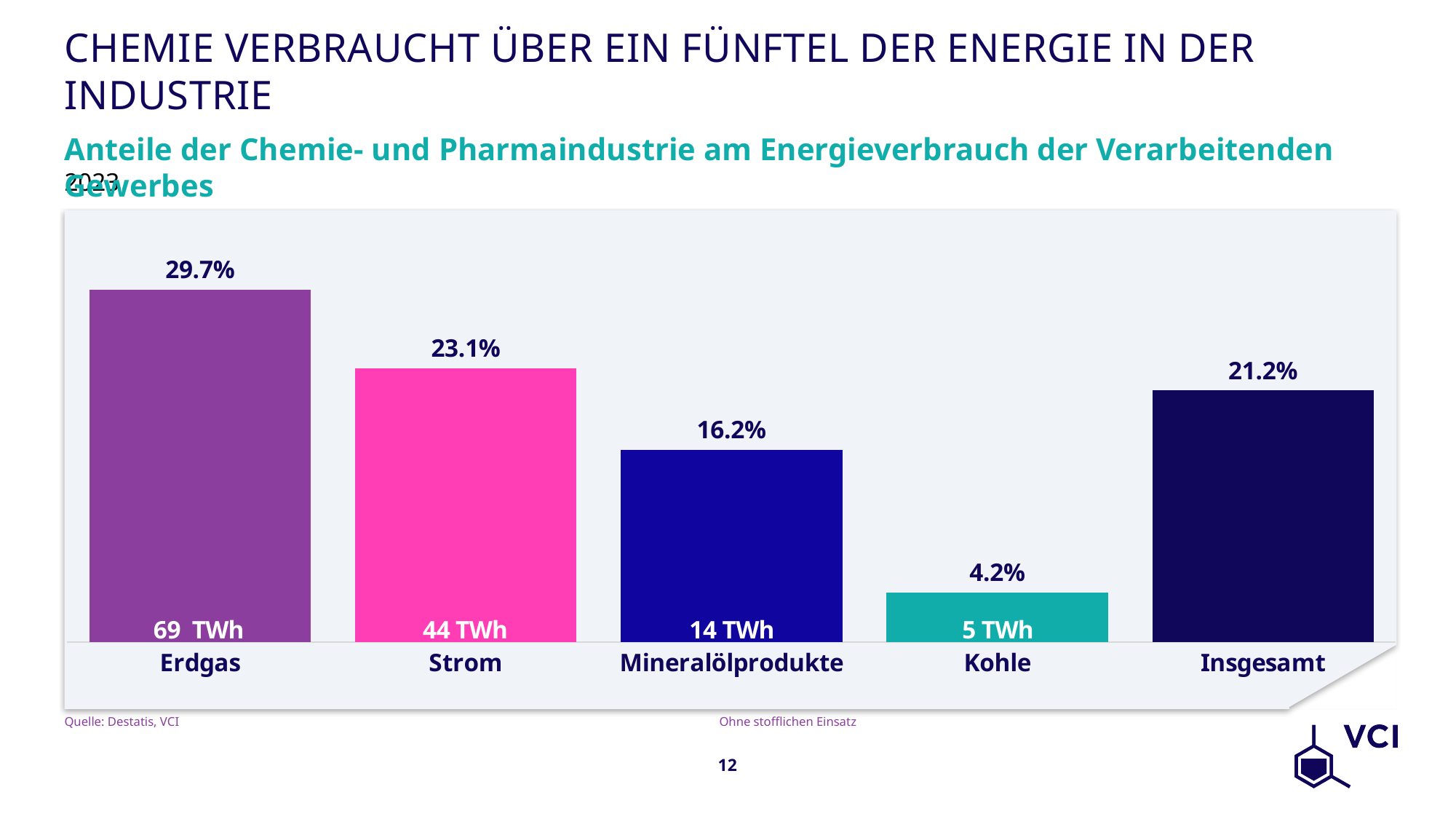
What is the difference in percentage points between Erdgas and Strom? 6.6 What is the percentage share shown for Strom? 23.1% What is the source cited below the chart? Destatis, VCI What is the percentage share shown for Erdgas? 29.7% What type of chart is shown on the slide? Bar chart How many TWh are shown inside the Mineralölprodukte bar? 14 TWh Which category has the highest percentage share? Erdgas Which category has the lowest percentage share? Kohle What is the percentage share shown for Insgesamt? 21.2% How many bars are shown in the chart? 5 What is the percentage share shown for Kohle? 4.2% Which has a larger percentage share, Mineralölprodukte or Insgesamt? Insgesamt